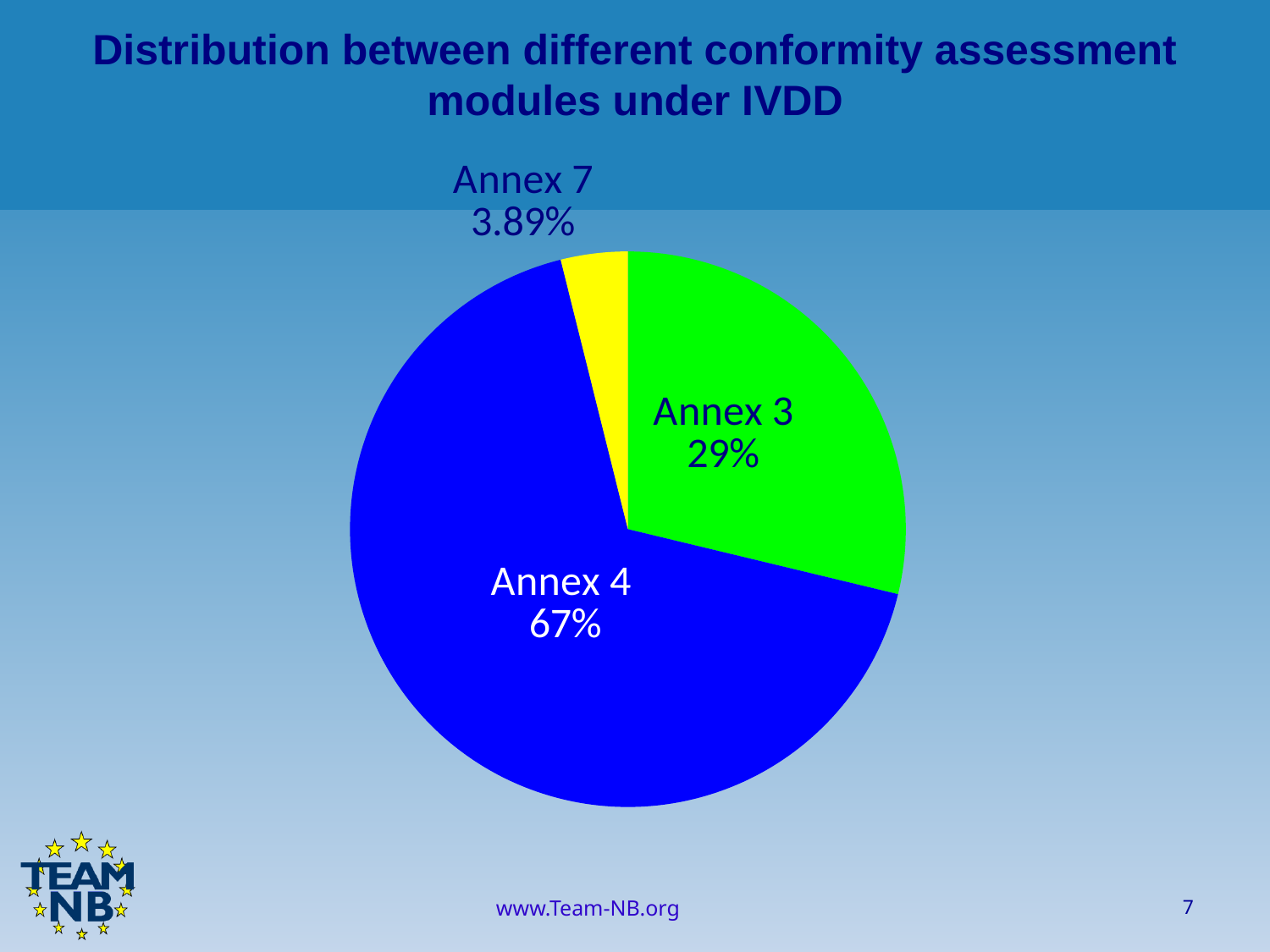
What is the difference in percentage points between the Annex 4 and Annex 3 shares? 38 Which has a larger share, Annex 3 or Annex 7? Annex 3 What share of the pie does Annex 3 represent? 29% What colour is the Annex 7 slice? Yellow What kind of chart is shown on the slide? Pie chart What share of the pie does Annex 4 represent? 67% Which annex has the largest share of the pie? Annex 4 What is the title of the chart? Distribution between different conformity assessment modules under IVDD How many slices does the pie chart have? 3 What share of the pie does Annex 7 represent? 3.89% Which annex has the smallest share of the pie? Annex 7